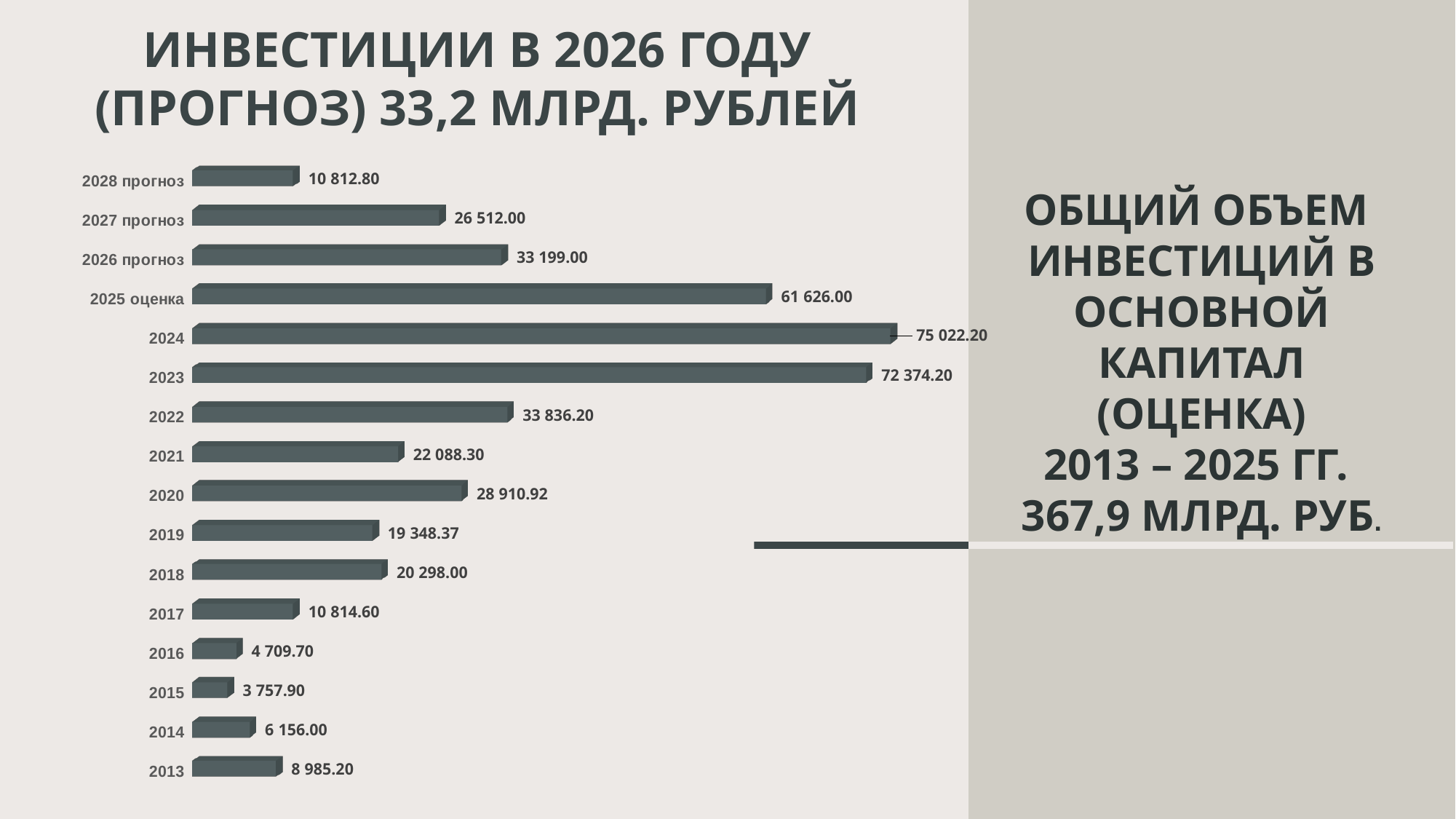
What is the value for 2015? 3 757.90 What kind of chart is shown on the slide? Bar chart What is the difference between the values for 2024 and 2023? 2 648.00 Which is larger, the value for 2020 or the value for 2021? 2020 Do the values rise or fall from 2024 to 2028 прогноз? Fall What is the difference between the values for 2022 and 2021? 11 747.90 What is the value for 2020? 28 910.92 How many categories are shown in the chart? 16 Which category has the lowest value? 2015 What is the value for 2026 прогноз? 33 199.00 Which category has the highest value? 2024 What is the value for 2024? 75 022.20